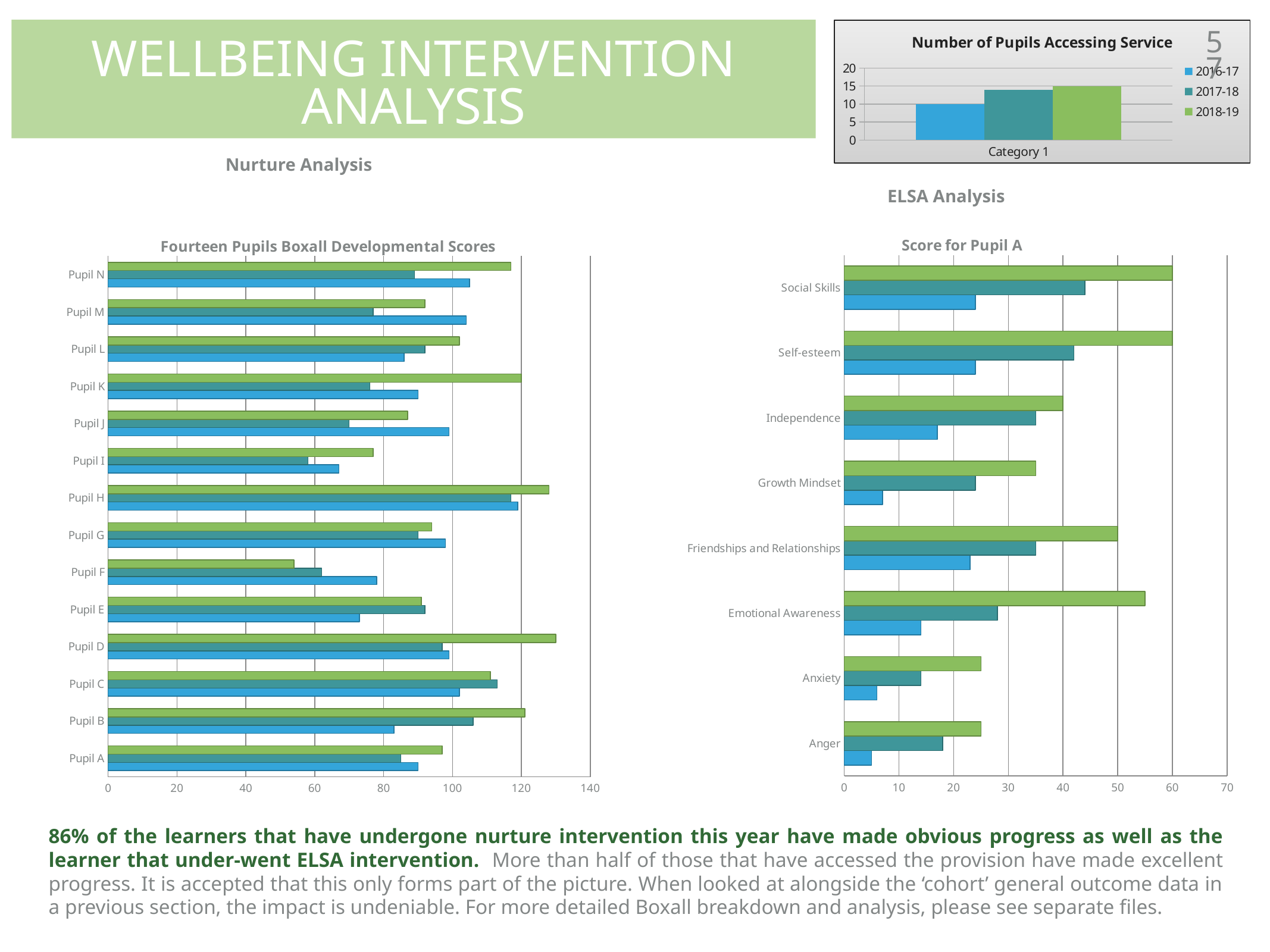
How many categories are shown on the 'Score for Pupil A' chart? 8 How many pupils are listed on the y axis of the 'Fourteen Pupils Boxall Developmental Scores' chart? 14 In the 'Number of Pupils Accessing Service' chart, which year has the highest value? 2018-19 In the 'Score for Pupil A' chart, which has the longer top (green) bar: Friendships and Relationships or Independence? Friendships and Relationships In the 'Number of Pupils Accessing Service' chart, what is the value for 2018-19? 15 What is the title of the chart on the left side of the slide? Fourteen Pupils Boxall Developmental Scores In the 'Number of Pupils Accessing Service' chart, what is the value for 2016-17? 10 How many series does the legend of the 'Number of Pupils Accessing Service' chart list? 3 In the 'Fourteen Pupils Boxall Developmental Scores' chart, is the longest bar for Pupil D greater or less than 120? greater In the 'Fourteen Pupils Boxall Developmental Scores' chart, is the top (green) bar for Pupil F greater or less than 60? less In the 'Score for Pupil A' chart, what is the value of the top (green) bar for Independence? 40 What kind of chart is the 'Fourteen Pupils Boxall Developmental Scores' chart? bar chart